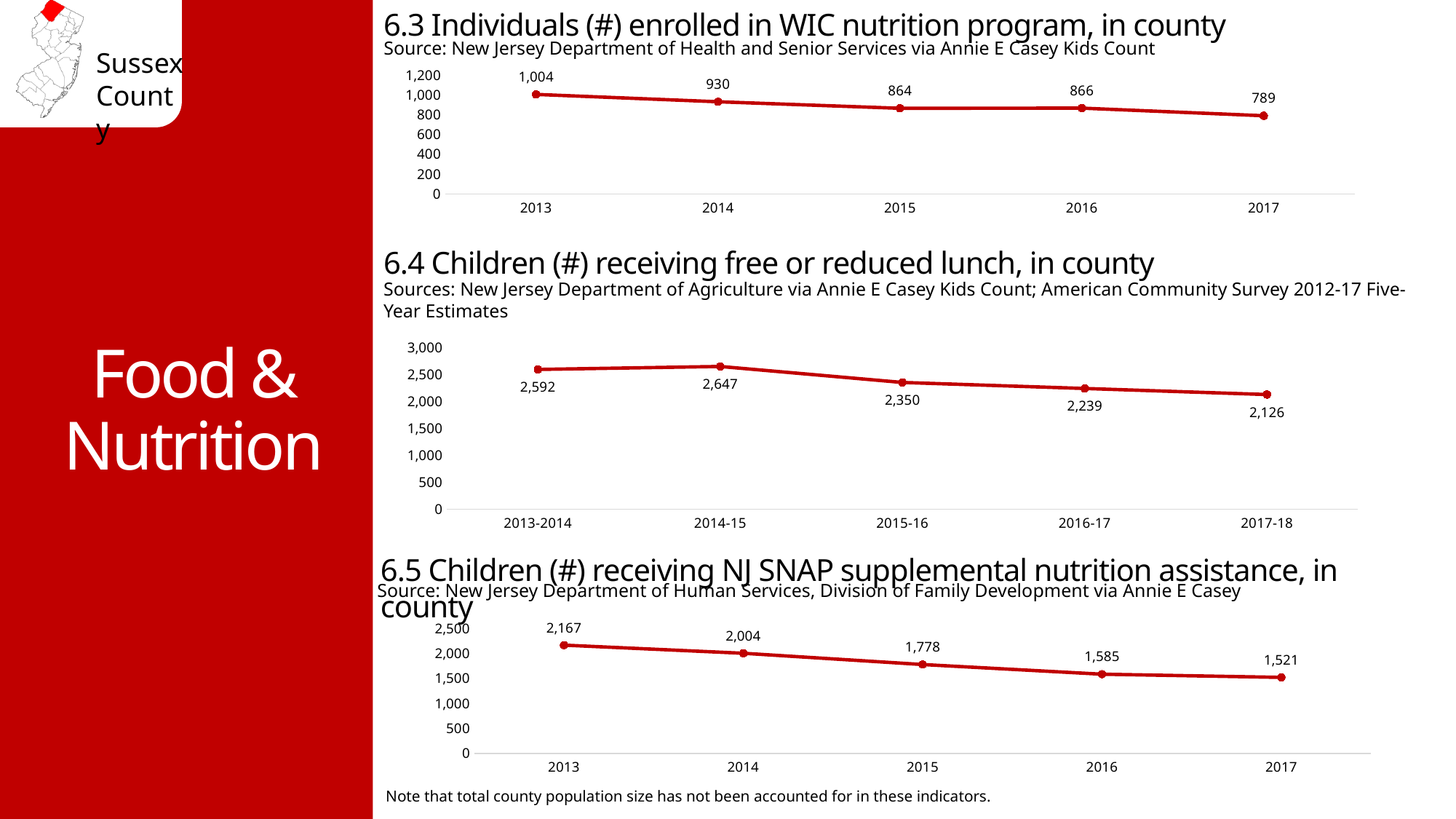
In the chart '6.3 Individuals (#) enrolled in WIC nutrition program, in county', what is the value for 2013? 1,004 In the chart '6.5 Children (#) receiving NJ SNAP supplemental nutrition assistance, in county', what is the value for 2016? 1,585 In the chart '6.4 Children (#) receiving free or reduced lunch, in county', is the value for 2016-17 larger or smaller than the value for 2017-18? larger In the chart '6.4 Children (#) receiving free or reduced lunch, in county', what kind of chart is shown? line chart In the chart '6.5 Children (#) receiving NJ SNAP supplemental nutrition assistance, in county', do the values rise or fall from 2013 to 2017? fall In the chart '6.3 Individuals (#) enrolled in WIC nutrition program, in county', what is the difference between the 2013 and 2017 values? 215 How many charts are shown on the slide? 3 In the chart '6.5 Children (#) receiving NJ SNAP supplemental nutrition assistance, in county', what is the difference between the 2013 and 2014 values? 163 In the chart '6.4 Children (#) receiving free or reduced lunch, in county', what is the value for 2015-16? 2,350 In the chart '6.4 Children (#) receiving free or reduced lunch, in county', which school year has the highest value? 2014-15 In the chart '6.3 Individuals (#) enrolled in WIC nutrition program, in county', which year has the lowest value? 2017 In the chart '6.3 Individuals (#) enrolled in WIC nutrition program, in county', how many years are plotted? 5